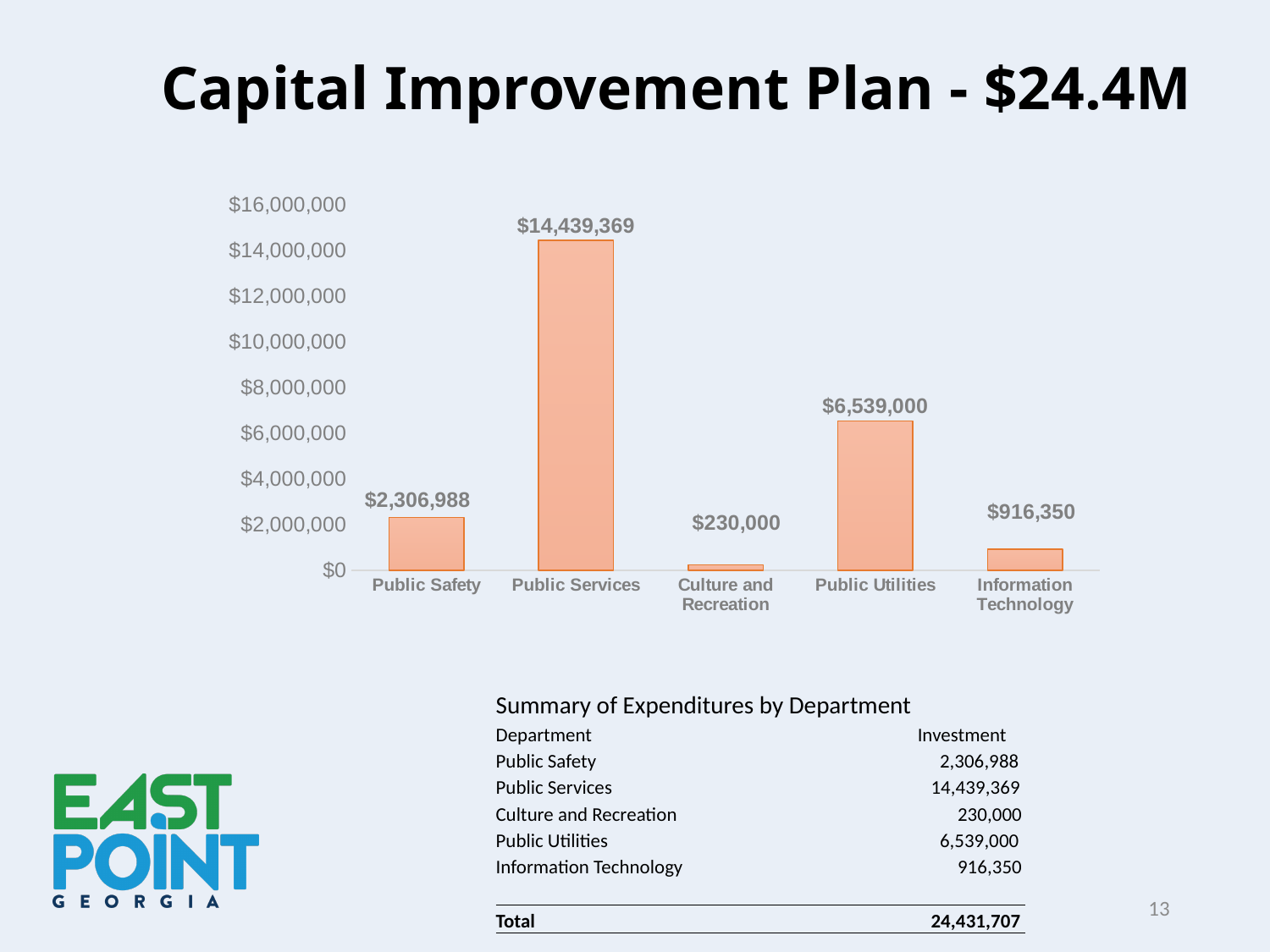
Which is larger, the value for Public Utilities or the value for Public Safety? Public Utilities What is the value for Public Services? $14,439,369 Is the value for Public Utilities greater or less than $6,000,000? greater What is the title of the slide containing the chart? Capital Improvement Plan - $24.4M What is the value for Information Technology? $916,350 Which department has the highest value? Public Services What kind of chart is shown on the slide? bar chart How many departments are shown on the chart? 5 Which department has the lowest value? Culture and Recreation What is the value for Culture and Recreation? $230,000 What is the difference between the values for Public Safety and Information Technology? $1,390,638 What is the difference between the values for Public Services and Public Utilities? $7,900,369